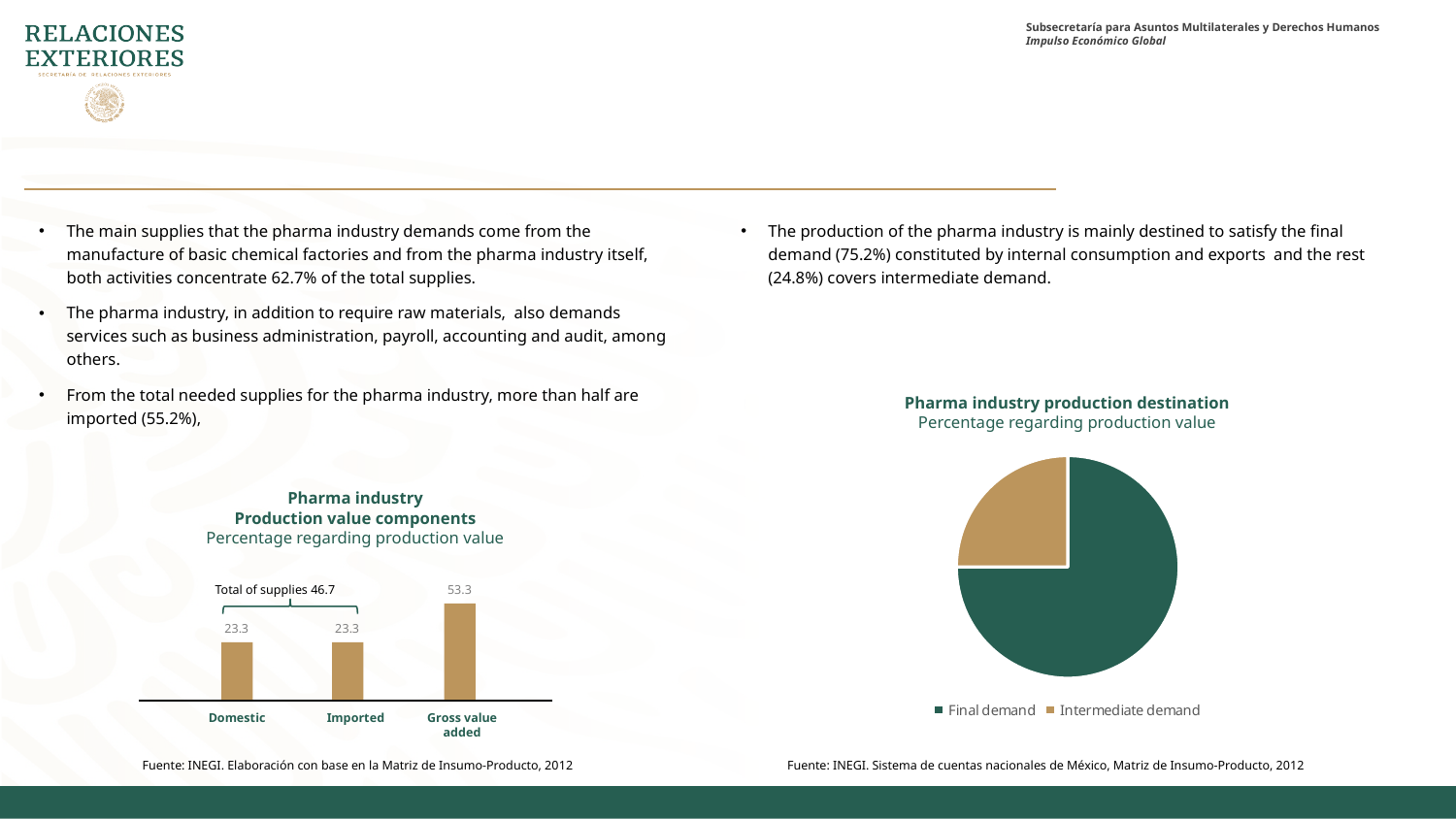
In the 'Pharma industry Production value components' chart, what is the value for Domestic? 23.3 In the 'Pharma industry Production value components' chart, what is the difference between Gross value added and Domestic? 30.0 In the 'Pharma industry Production value components' chart, which category has the highest value? Gross value added In the 'Pharma industry Production value components' chart, what is the value for Imported? 23.3 What kind of chart is the 'Pharma industry production destination' chart? Pie chart In the 'Pharma industry Production value components' chart, what is the value for Gross value added? 53.3 In the 'Pharma industry production destination' chart, which slice is larger, Final demand or Intermediate demand? Final demand What kind of chart is the 'Pharma industry Production value components' chart? Bar chart How many categories are shown in the 'Pharma industry Production value components' chart? 3 In the 'Pharma industry Production value components' chart, what total of supplies is indicated by the bracket above the Domestic and Imported bars? 46.7 In the 'Pharma industry Production value components' chart, which is larger, Gross value added or Imported? Gross value added How many entries does the legend of the 'Pharma industry production destination' chart list? 2